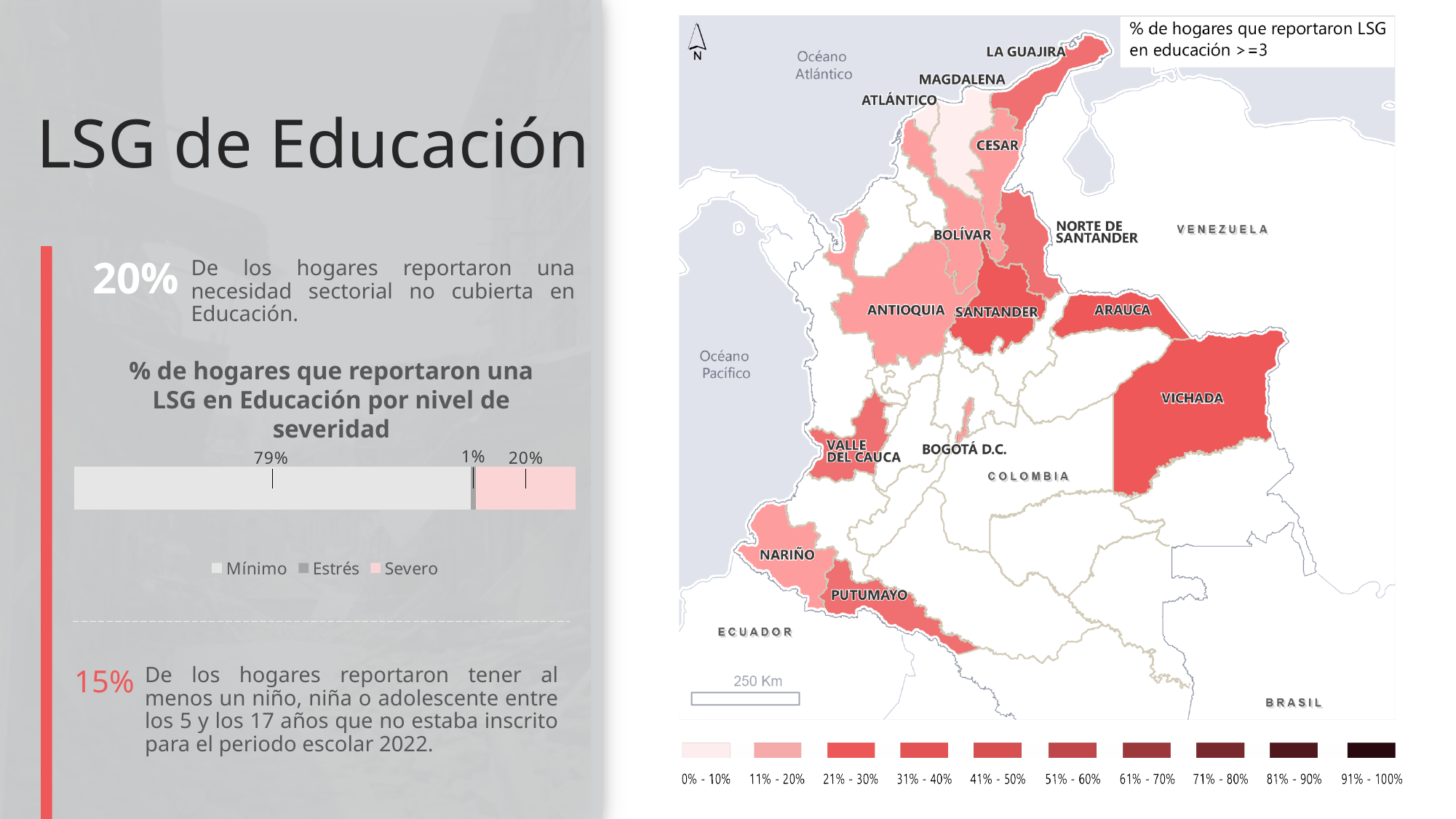
In the stacked bar chart on the left, which is larger, Severo or Estrés? Severo In the map on the right, what is the highest range shown in the colour legend? 91% - 100% How many series does the legend of the stacked bar chart on the left list? 3 What kind of chart is shown under the title '% de hogares que reportaron una LSG en Educación por nivel de severidad'? Stacked bar chart In the stacked bar chart on the left, what are the legend entries in order? Mínimo, Estrés, Severo In the chart '% de hogares que reportaron una LSG en Educación por nivel de severidad', what is the value for Estrés? 1% In the stacked bar chart on the left, which severity level has the lowest value? Estrés In the stacked bar chart on the left, what is the difference between the Mínimo and Severo values? 59% In the stacked bar chart on the left, which severity level has the highest value? Mínimo In the stacked bar chart on the left, what is the total of the three segments? 100% In the chart '% de hogares que reportaron una LSG en Educación por nivel de severidad', what is the value for Mínimo? 79% In the chart '% de hogares que reportaron una LSG en Educación por nivel de severidad', what is the value for Severo? 20%